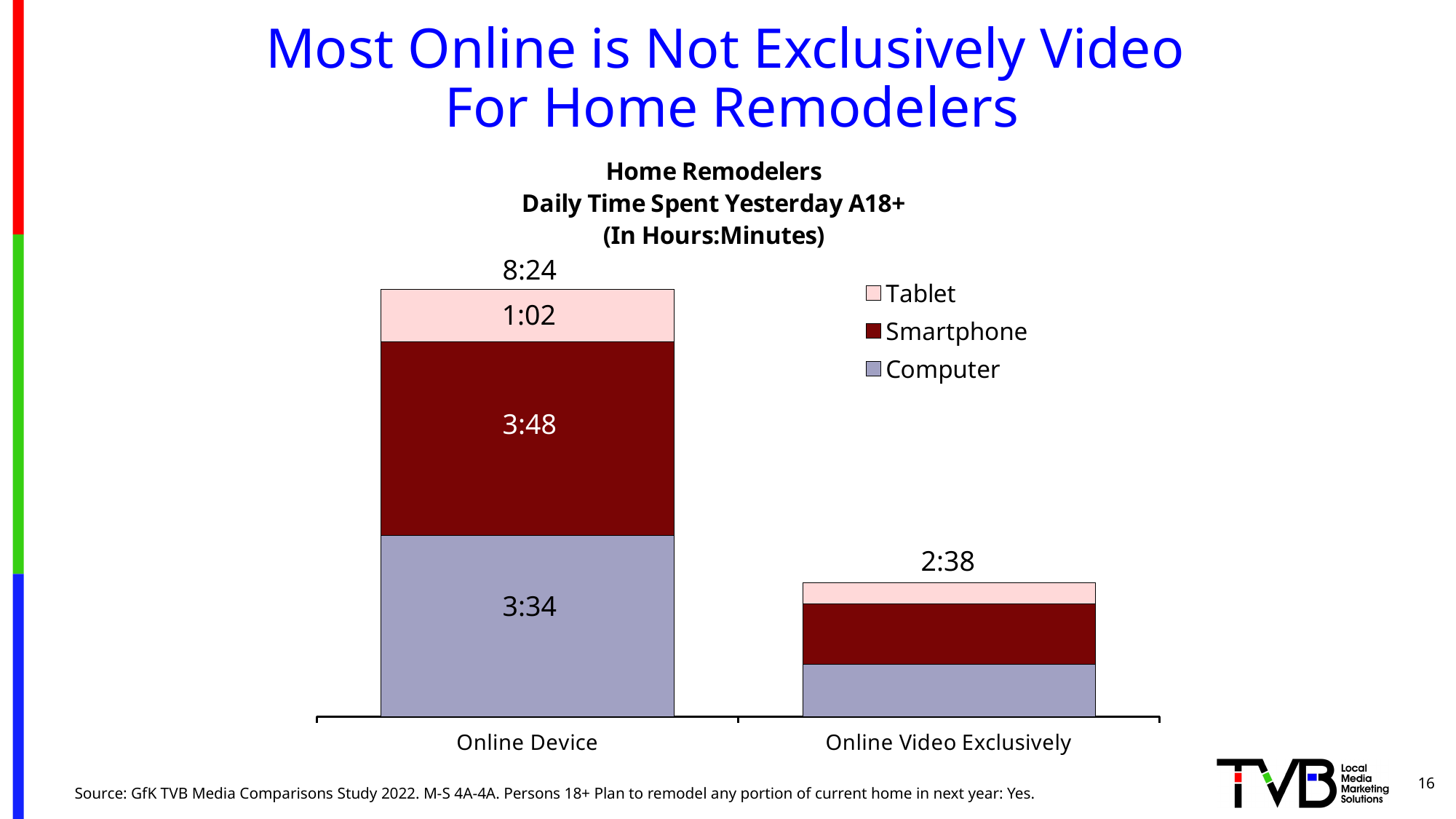
How many series does the legend list? 3 How many categories are shown on the x axis? 2 What kind of chart is shown on the slide? Stacked bar chart Which category has the higher total, Online Device or Online Video Exclusively? Online Device What is the total daily time spent for Online Video Exclusively? 2:38 What is the Computer value for Online Device? 3:34 Within the Online Device bar, which device accounts for the least time? Tablet What is the Tablet value for Online Device? 1:02 Within the Online Device bar, which device accounts for the most time? Smartphone What is the total daily time spent for Online Device? 8:24 What is the difference between the Online Device total and the Online Video Exclusively total? 5:46 What is the Smartphone value for Online Device? 3:48